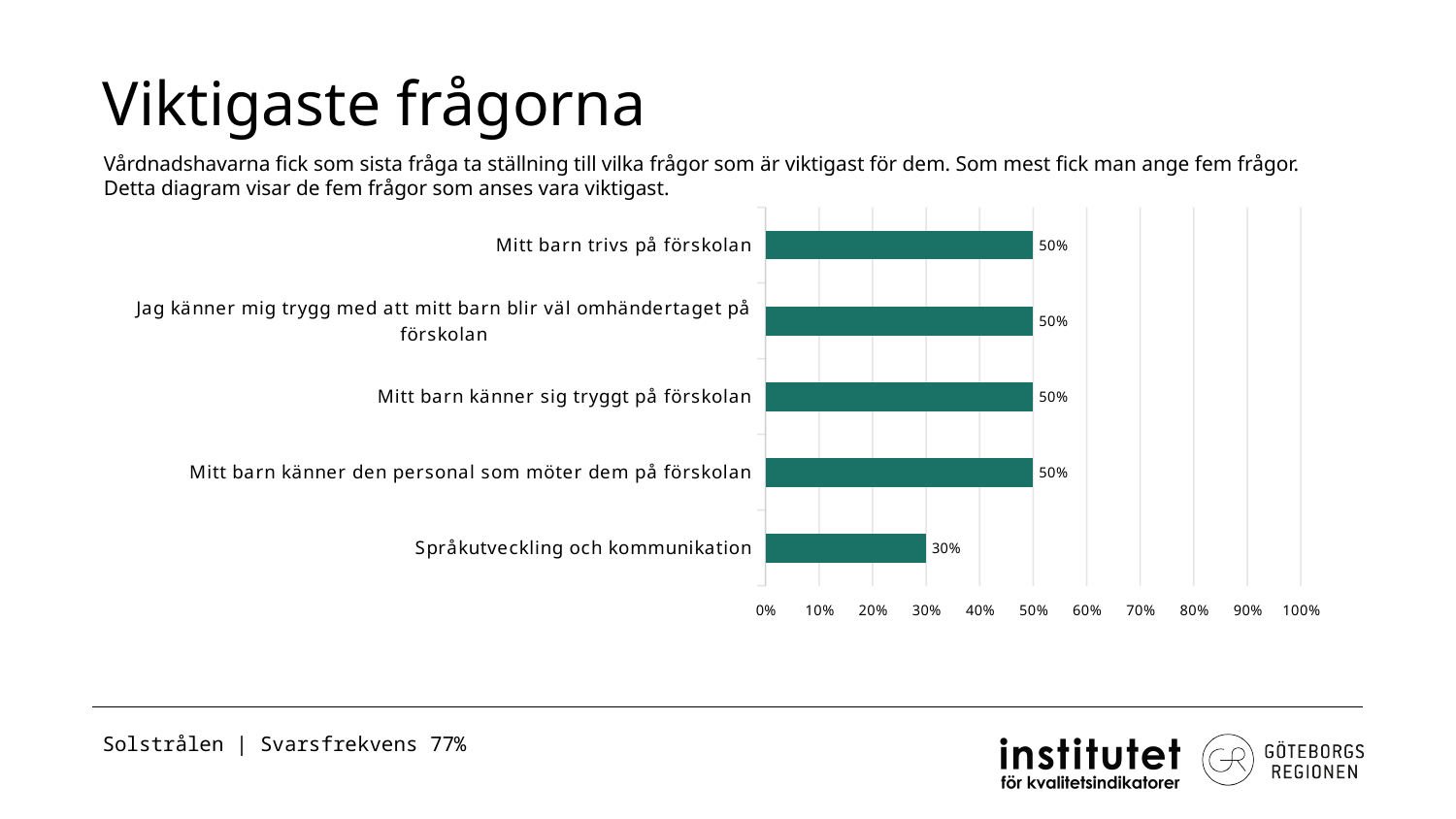
What is the highest value shown on the x axis of the chart? 100% How many categories have a value of 50%? 4 Which category has the lowest value? Språkutveckling och kommunikation What kind of chart is shown on the slide? Bar chart What is the difference between the value for "Mitt barn känner sig tryggt på förskolan" and the value for "Språkutveckling och kommunikation"? 20 percentage points What is the value for "Språkutveckling och kommunikation"? 30% Which is larger: the value for "Mitt barn trivs på förskolan" or the value for "Språkutveckling och kommunikation"? Mitt barn trivs på förskolan What is the value for "Mitt barn trivs på förskolan"? 50% What is the value for "Jag känner mig trygg med att mitt barn blir väl omhändertaget på förskolan"? 50% What is the value for "Mitt barn känner den personal som möter dem på förskolan"? 50% How many categories are shown in the chart? 5 Is the value for "Språkutveckling och kommunikation" greater or less than 40%? less